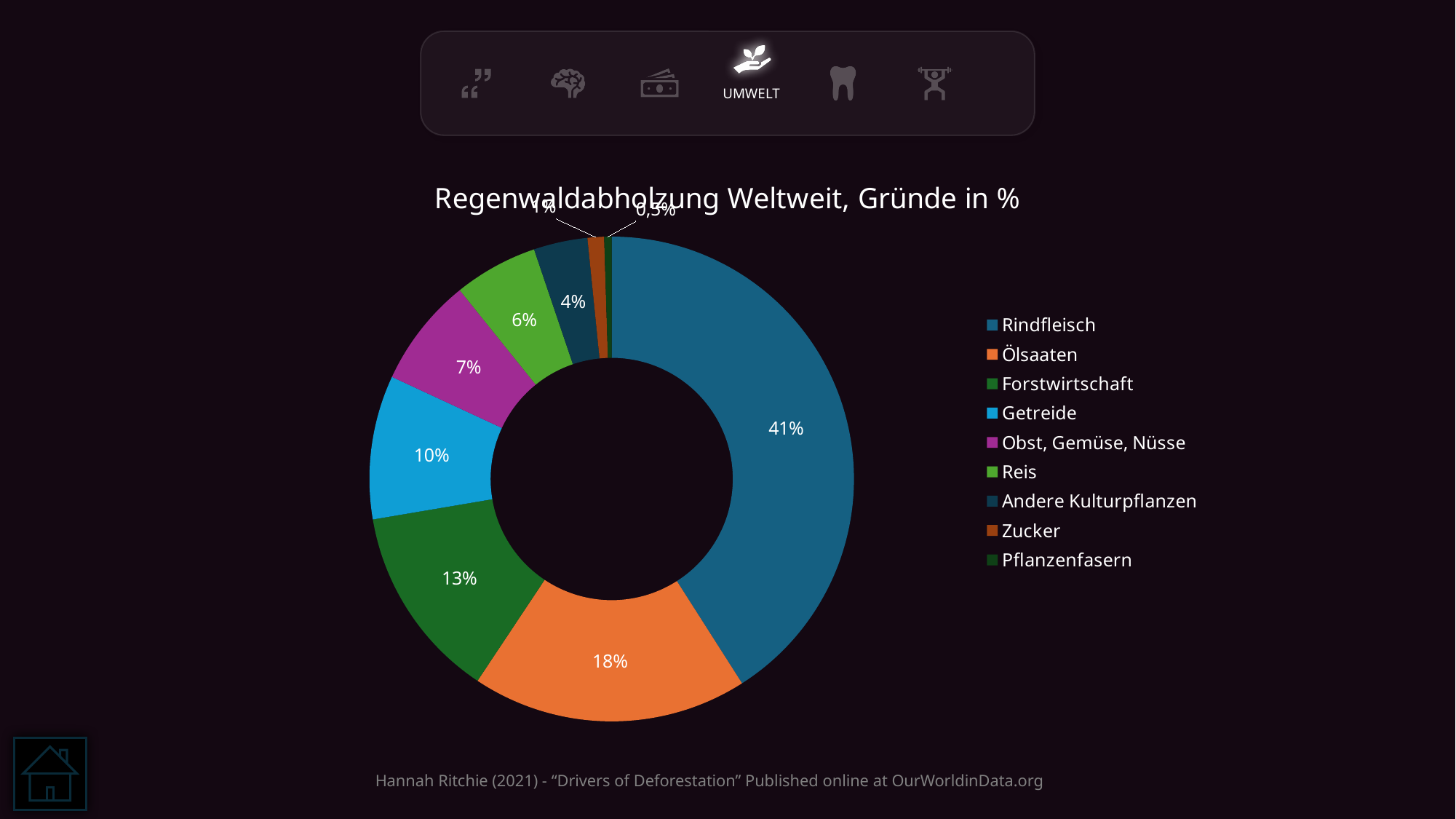
What percentage is shown for Rindfleisch? 41% Which is larger, the share for Forstwirtschaft or the share for Getreide? Forstwirtschaft What percentage is shown for Reis? 6% What is the title of the chart? Regenwaldabholzung Weltweit, Gründe in % What percentage is shown for Ölsaaten? 18% How many categories does the legend list? 9 What is the difference between the shares of Rindfleisch and Ölsaaten? 23% What kind of chart is shown on the slide? doughnut chart What percentage is shown for Getreide? 10% What percentage is shown for Andere Kulturpflanzen? 4% Which category has the smallest share of the chart? Pflanzenfasern Which category has the largest share of the chart? Rindfleisch